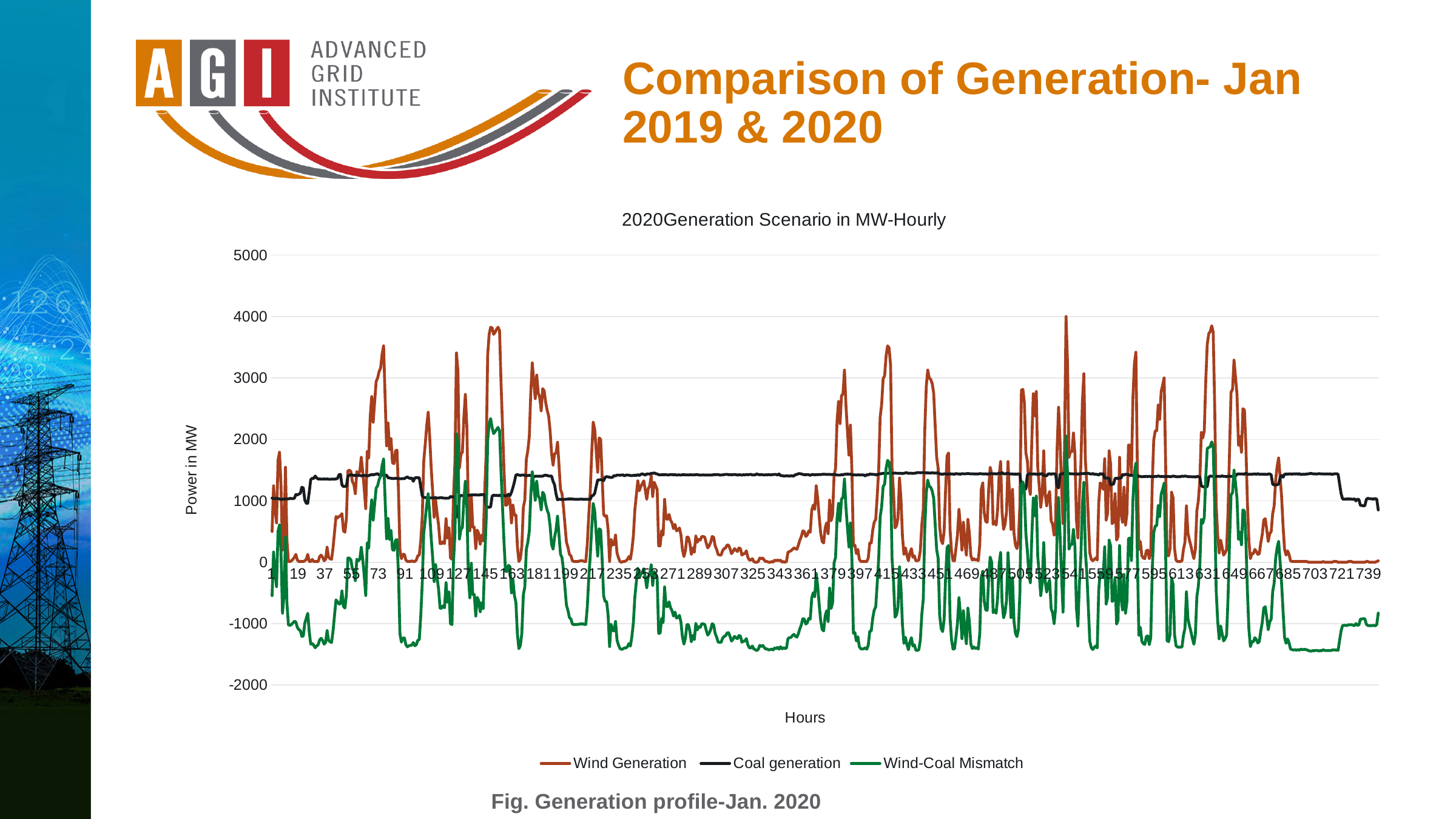
Which series has a higher peak value, Wind Generation or Coal generation? Wind Generation Is the peak value of Wind Generation greater or less than 3000? greater Is the lowest value of Wind-Coal Mismatch greater or less than -1000? less Is the highest value of Coal generation greater or less than 2000? less How many series does the legend list? 3 Which series reaches the lowest value on the chart? Wind-Coal Mismatch What is the label of the vertical axis? Power in MW What is the title of the chart? 2020Generation Scenario in MW-Hourly What is the highest value shown on the vertical axis? 5000 What kind of chart is shown on the slide? Line chart Which series reaches the highest value on the chart? Wind Generation